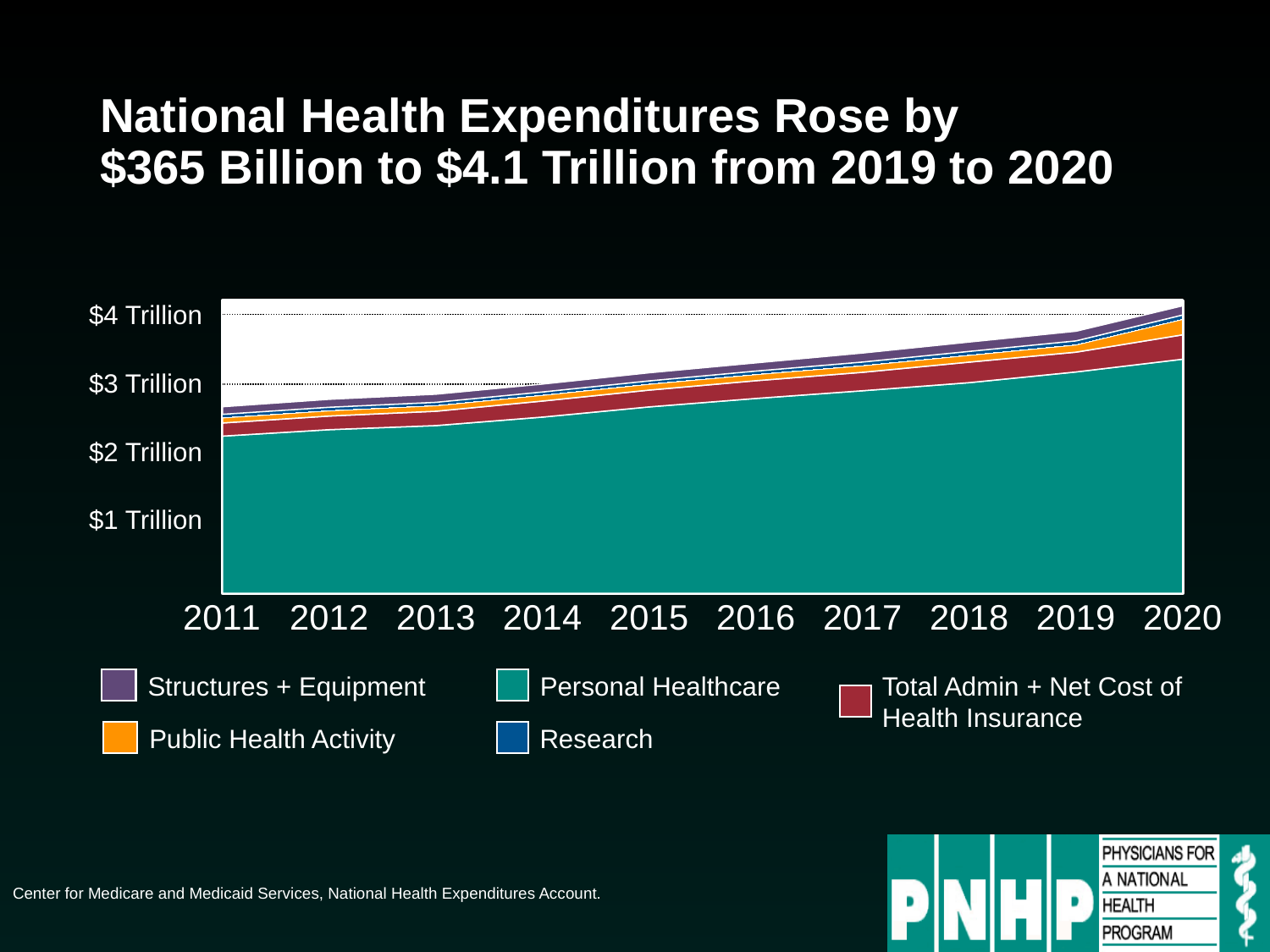
Which series accounts for the largest share of national health expenditures in 2020? Personal Healthcare Is the total national health expenditure in 2011 greater or less than $2 Trillion? greater What colour represents Public Health Activity in the chart's legend? Orange What is the title of the chart on the slide? National Health Expenditures Rose by $365 Billion to $4.1 Trillion from 2019 to 2020 Is the value for Personal Healthcare in 2020 greater or less than $3 Trillion? greater How many series does the chart's legend list? 5 Is the total national health expenditure in 2015 greater or less than $4 Trillion? less How many years are shown along the x axis of the chart? 10 Do total national health expenditures rise or fall from 2011 to 2020? Rise Which series accounts for the smallest share of national health expenditures in 2020? Research What kind of chart is shown on the slide? Stacked area chart